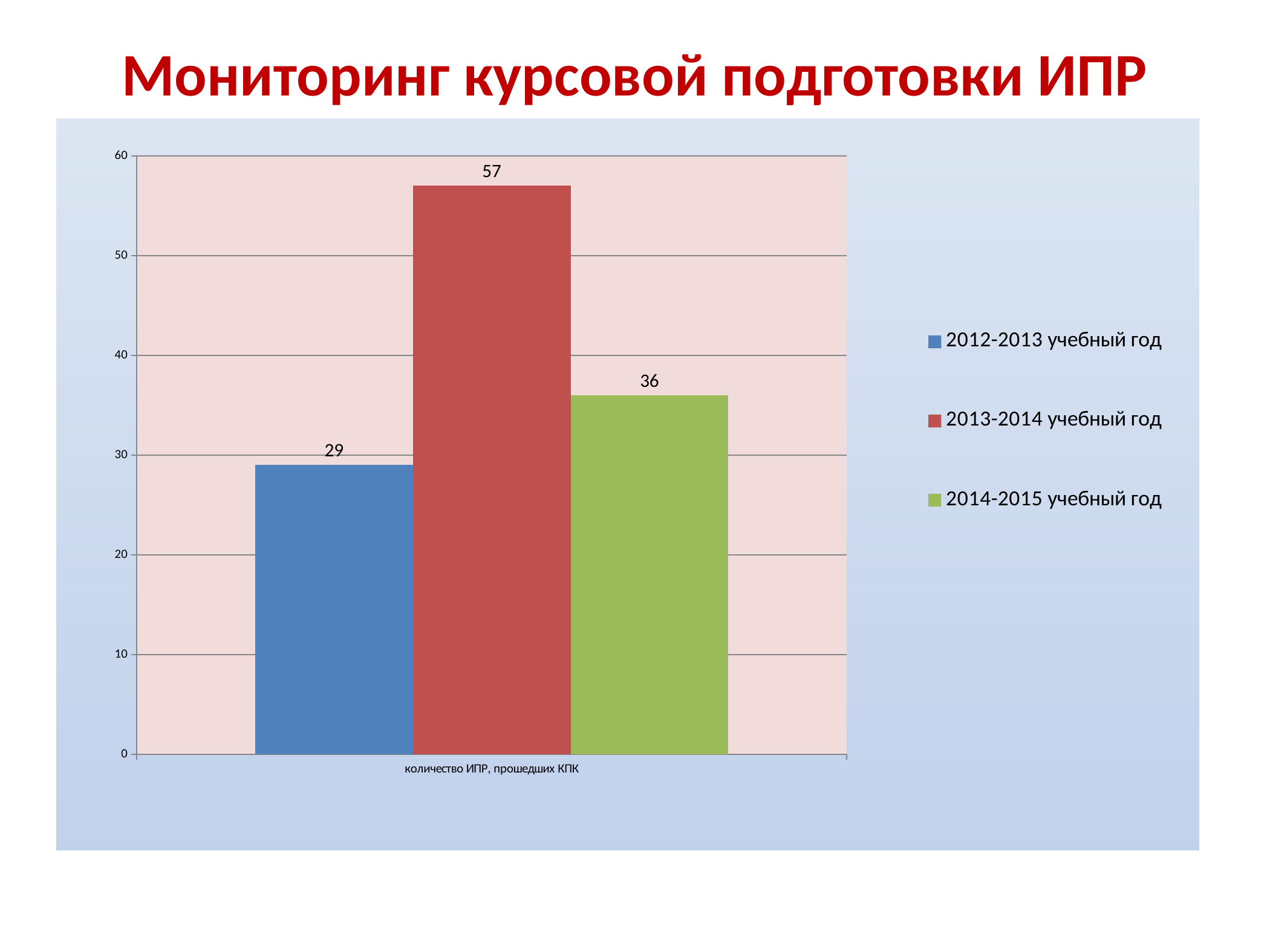
What is the value for the 2012-2013 учебный год series? 29 What is the value for the 2013-2014 учебный год series? 57 What is the value for the 2014-2015 учебный год series? 36 What kind of chart is shown on the slide? bar chart Is the value for 2013-2014 учебный год greater or less than 50? greater How many series does the legend list? 3 Which series has the highest value? 2013-2014 учебный год Which series has the lowest value? 2012-2013 учебный год Which is larger, the value for 2014-2015 учебный год or the value for 2012-2013 учебный год? 2014-2015 учебный год What is the label on the x axis under the bars? количество ИПР, прошедших КПК What is the difference between the values for 2013-2014 учебный год and 2012-2013 учебный год? 28 What is the difference between the values for 2013-2014 учебный год and 2014-2015 учебный год? 21